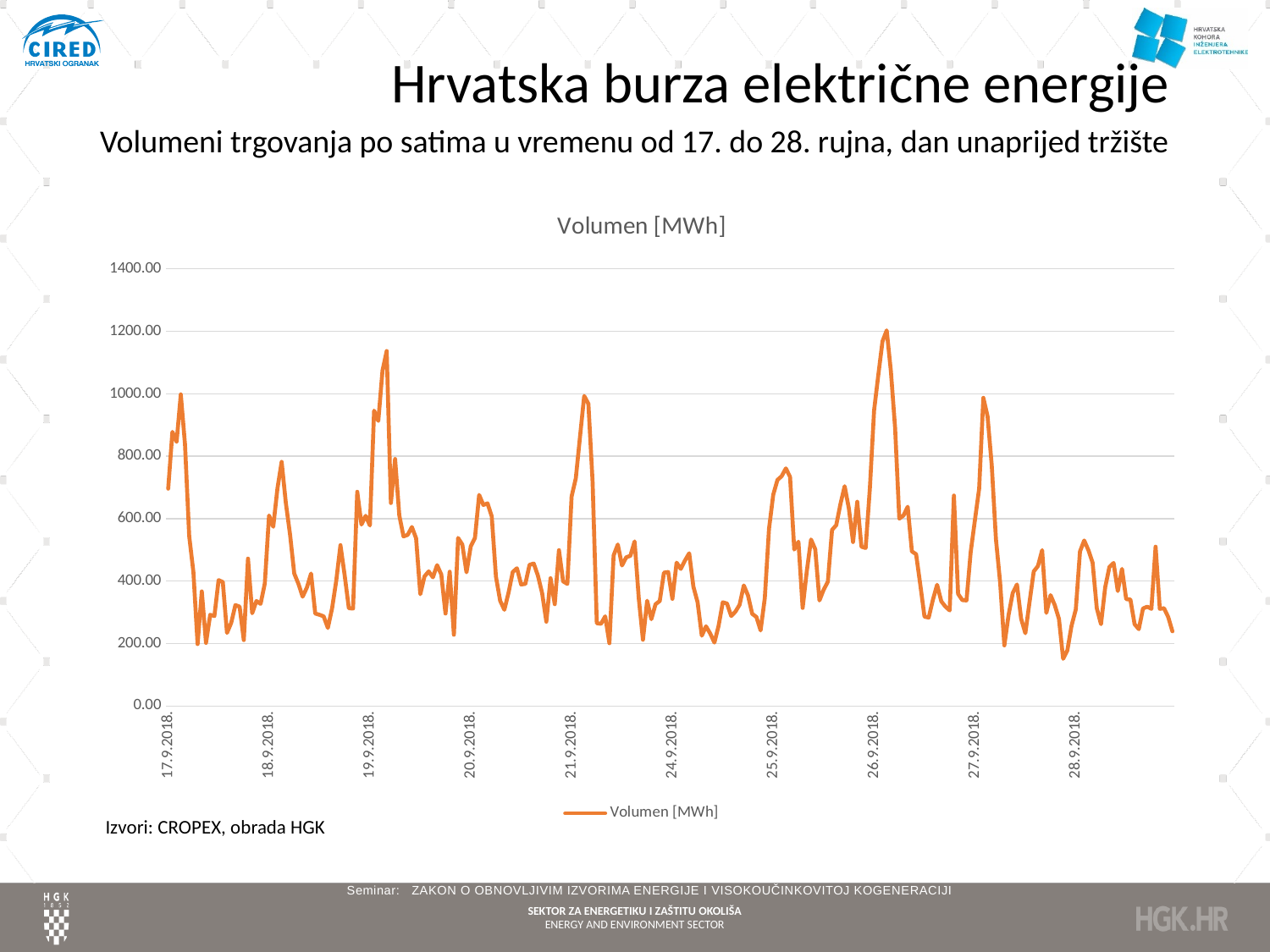
Is the lowest point of the line, around 28.9.2018., greater or less than 200? less What is the highest value shown on the y axis of the chart? 1400.00 What kind of chart is shown on the slide? line chart What is the name of the series shown in the chart legend? Volumen [MWh] What is the title of the chart? Volumen [MWh] Is the peak of the line around 21.9.2018. greater or less than 800? greater How many date labels are shown on the x axis of the chart? 10 On which date does the line reach its highest peak? 26.9.2018. Is the highest peak of the line, around 26.9.2018., greater or less than 1000? greater How many series does the chart legend list? 1 Which peak is higher: the one around 26.9.2018. or the one around 27.9.2018.? 26.9.2018.